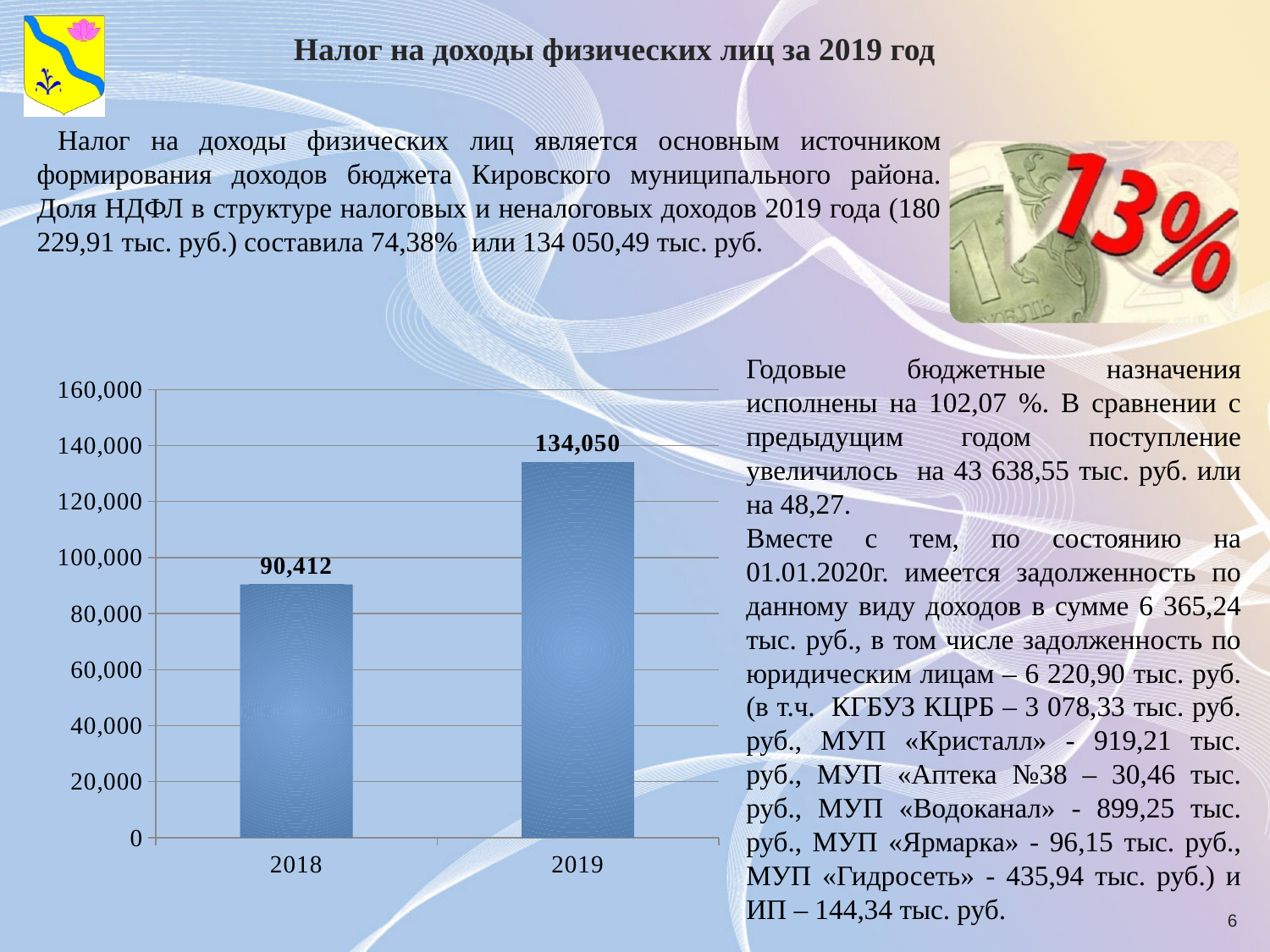
Do the values rise or fall from 2018 to 2019? rise Is the value for 2018 larger or smaller than the value for 2019? smaller Which year has the lower value on the chart? 2018 Is the value for 2019 greater or less than 120,000? greater What is the value shown for 2019 on the chart? 134,050 Which year has the higher value on the chart? 2019 What type of chart is shown on the slide? bar chart What is the difference between the 2019 and 2018 values on the chart? 43,638 What is the highest tick value shown on the chart's vertical axis? 160,000 How many bars are plotted on the chart? 2 Is the value for 2018 greater or less than 100,000? less What is the value shown for 2018 on the chart? 90,412